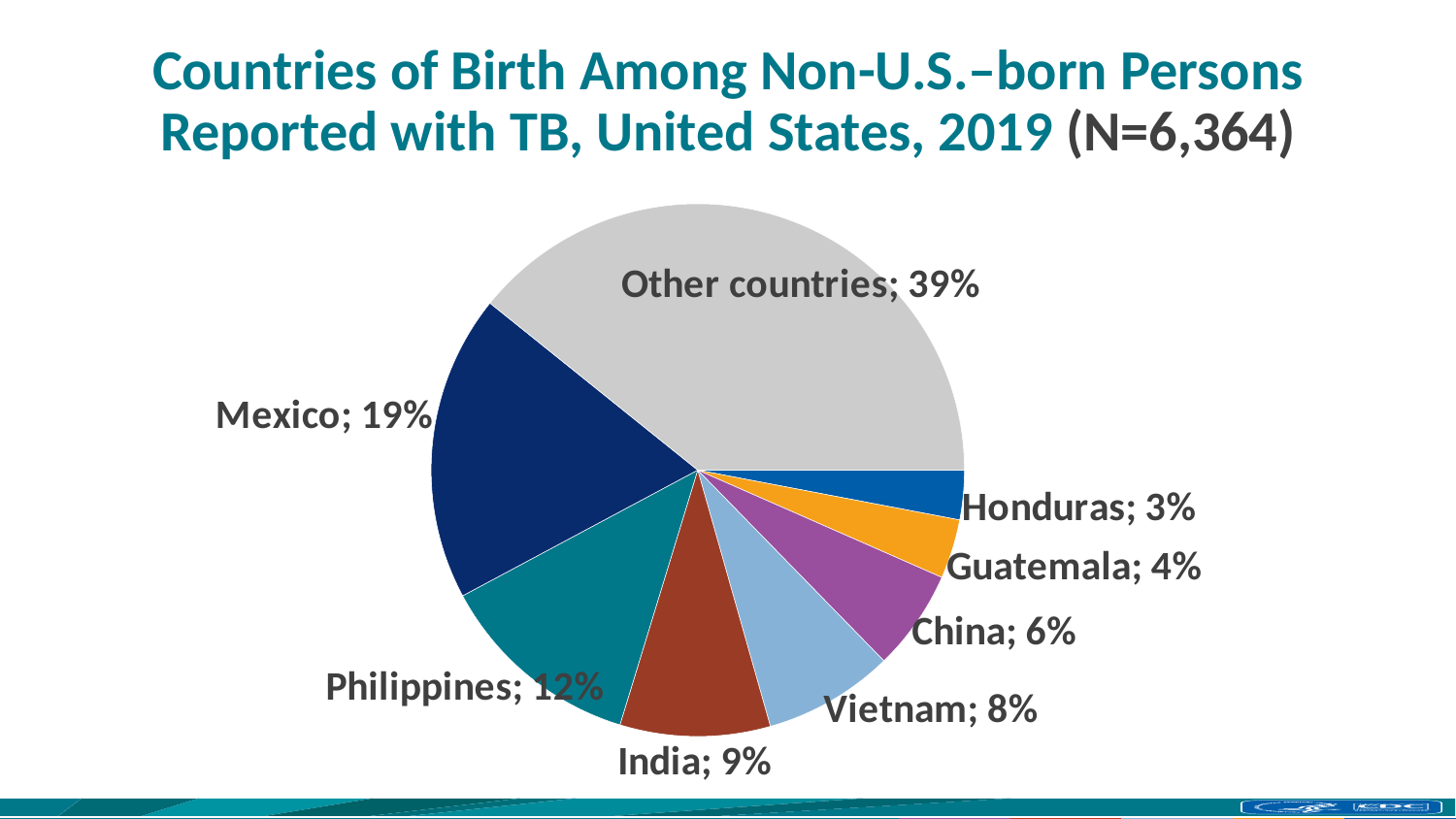
What year does the chart title refer to? 2019 Which named country has the smallest slice? Honduras What kind of chart is shown on the slide? Pie chart What share of the pie does Mexico account for? 19% What is the value shown for the Philippines? 12% Which slice of the pie is the largest? Other countries How many slices does the pie chart have? 8 What is the value shown for Vietnam? 8% What is the total N stated in the chart title? 6,364 Which is larger, the slice for China or the slice for Guatemala? China What is the combined share of Honduras and Guatemala? 7% What is the difference in percentage points between Mexico and India? 10